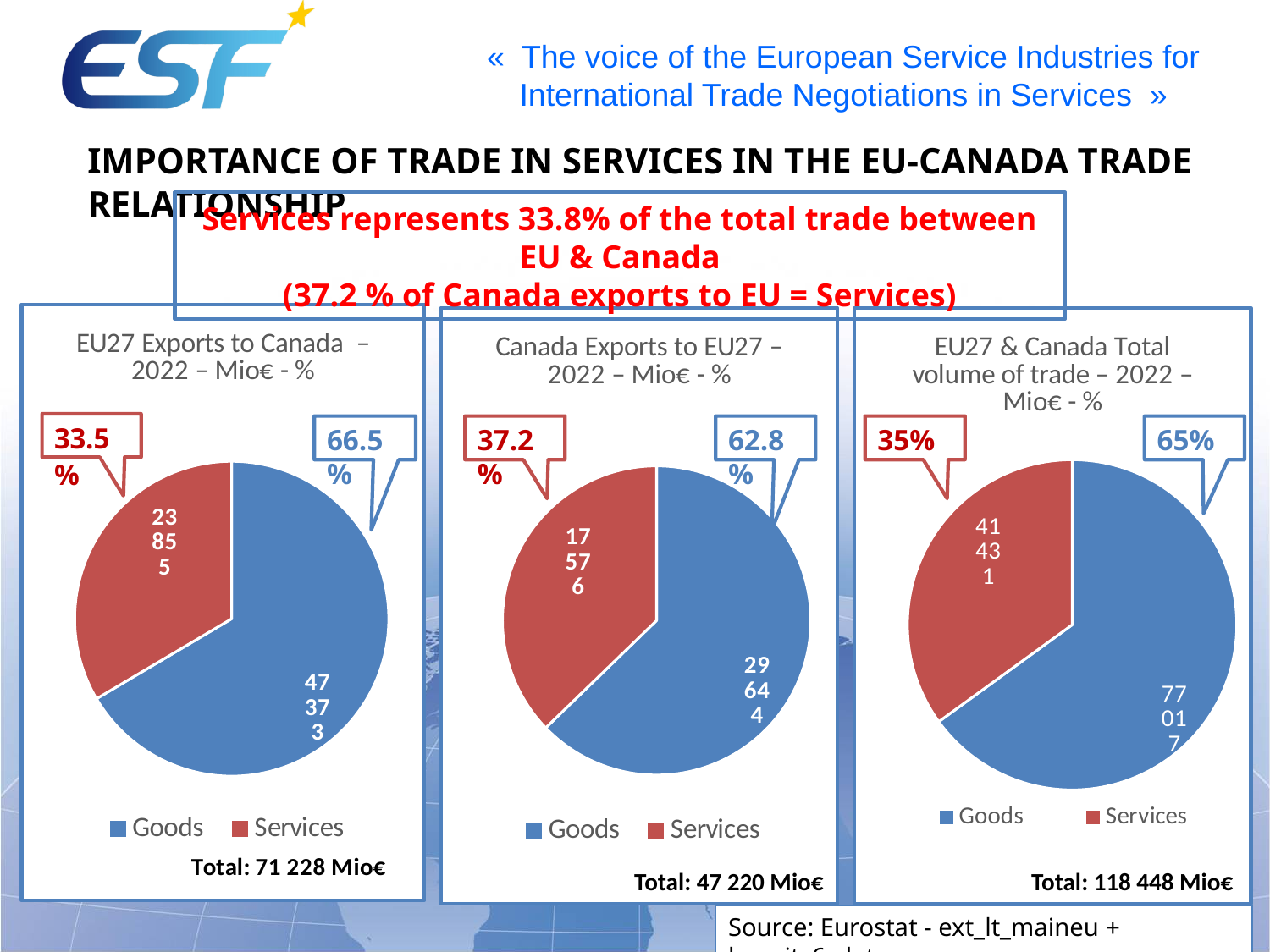
In the 'EU27 & Canada Total volume of trade – 2022' chart, what share of the pie is Goods? 65% In the 'Canada Exports to EU27 – 2022' chart, what share of the pie is Goods? 62.8% In the 'Canada Exports to EU27 – 2022' chart, what share of the pie is Services? 37.2% In the 'Canada Exports to EU27 – 2022' chart, which category is the smallest? Services How many series does the legend of the 'EU27 & Canada Total volume of trade – 2022' chart list? 2 In the 'EU27 Exports to Canada – 2022' chart, which category is larger, Goods or Services? Goods What kind of chart is the 'EU27 Exports to Canada – 2022' chart? pie chart What total is printed below the 'Canada Exports to EU27 – 2022' chart? Total: 47 220 Mio€ What total is printed below the 'EU27 & Canada Total volume of trade – 2022' chart? Total: 118 448 Mio€